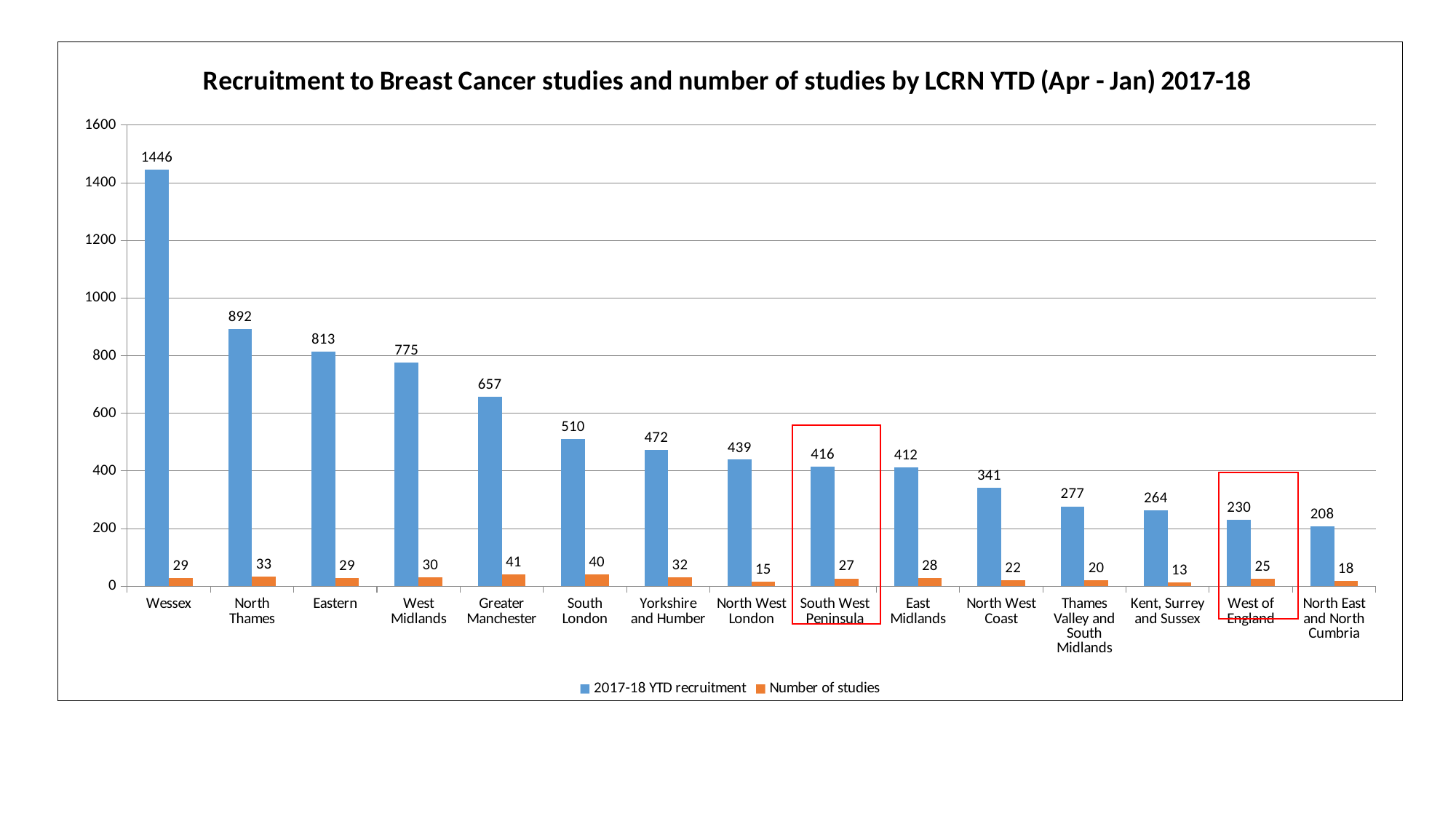
Do the 2017-18 YTD recruitment values rise or fall from left to right along the x axis? Fall How many LCRNs are shown on the x axis? 15 Is the 2017-18 YTD recruitment for South London greater or less than 400? greater What is the 2017-18 YTD recruitment value for South West Peninsula? 416 How many studies are shown for Greater Manchester? 41 Which LCRN has the highest 2017-18 YTD recruitment? Wessex Which LCRN has the lowest number of studies? Kent, Surrey and Sussex What is the difference in 2017-18 YTD recruitment between North Thames and Eastern? 79 Which has the higher 2017-18 YTD recruitment, West Midlands or Greater Manchester? West Midlands How many series does the legend list? 2 What is the 2017-18 YTD recruitment value for Wessex? 1446 What type of chart is shown on the slide? Bar chart